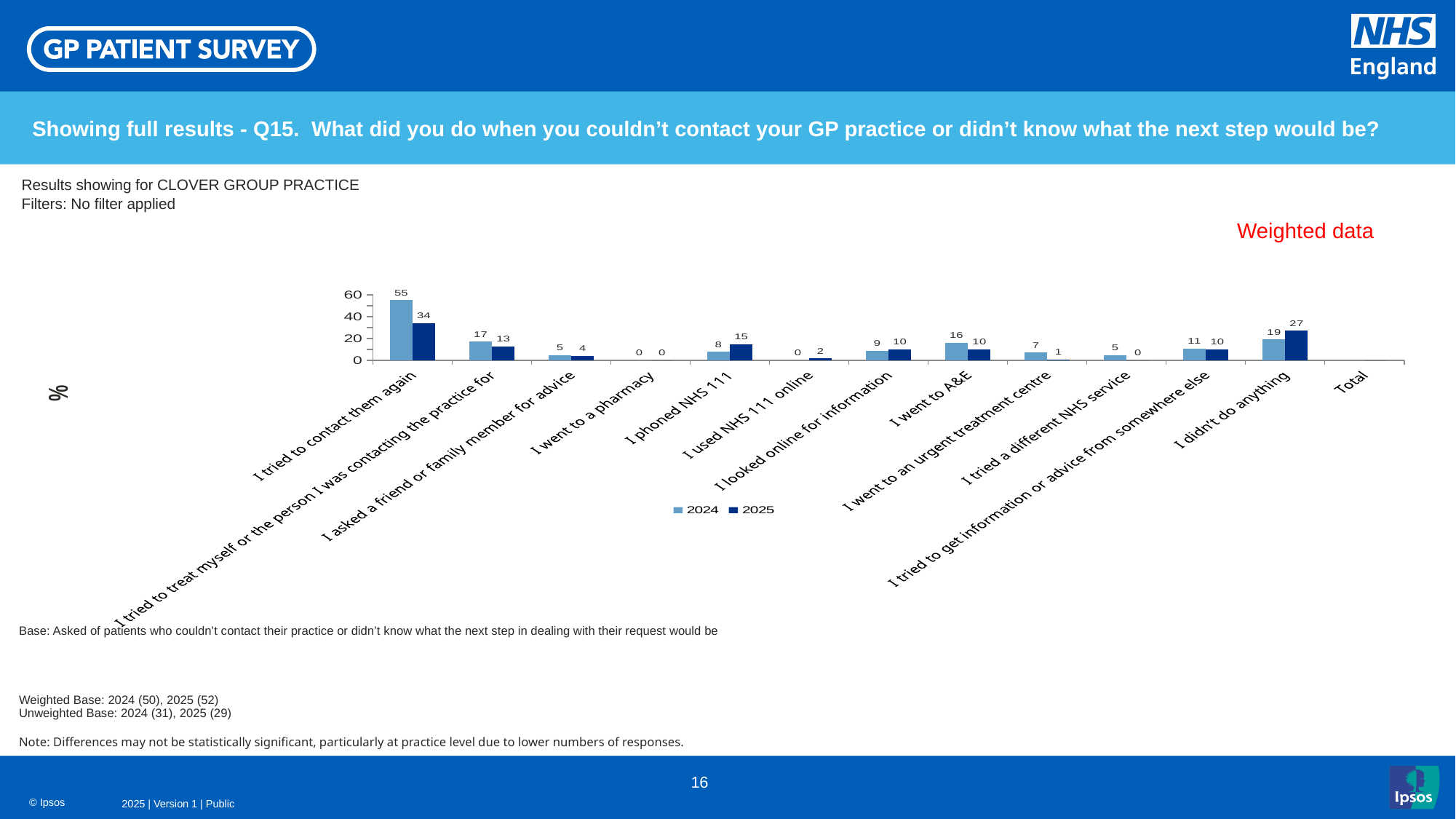
How many series does the legend list? 2 What is the difference between the 2025 and 2024 values for "I didn't do anything"? 8 Which is larger for "I phoned NHS 111": the 2024 value or the 2025 value? 2025 What is the 2024 value for "I went to A&E"? 16 What is the 2025 value for "I didn't do anything"? 27 What is the 2025 value for "I tried a different NHS service"? 0 What is the 2025 value for "I phoned NHS 111"? 15 What is the difference between the 2024 and 2025 values for "I tried to contact them again"? 21 What kind of chart is shown on the slide? Bar chart Which is larger for "I went to A&E": the 2024 value or the 2025 value? 2024 Which category has the highest 2025 value? I tried to contact them again What is the 2024 value for "I tried to contact them again"? 55